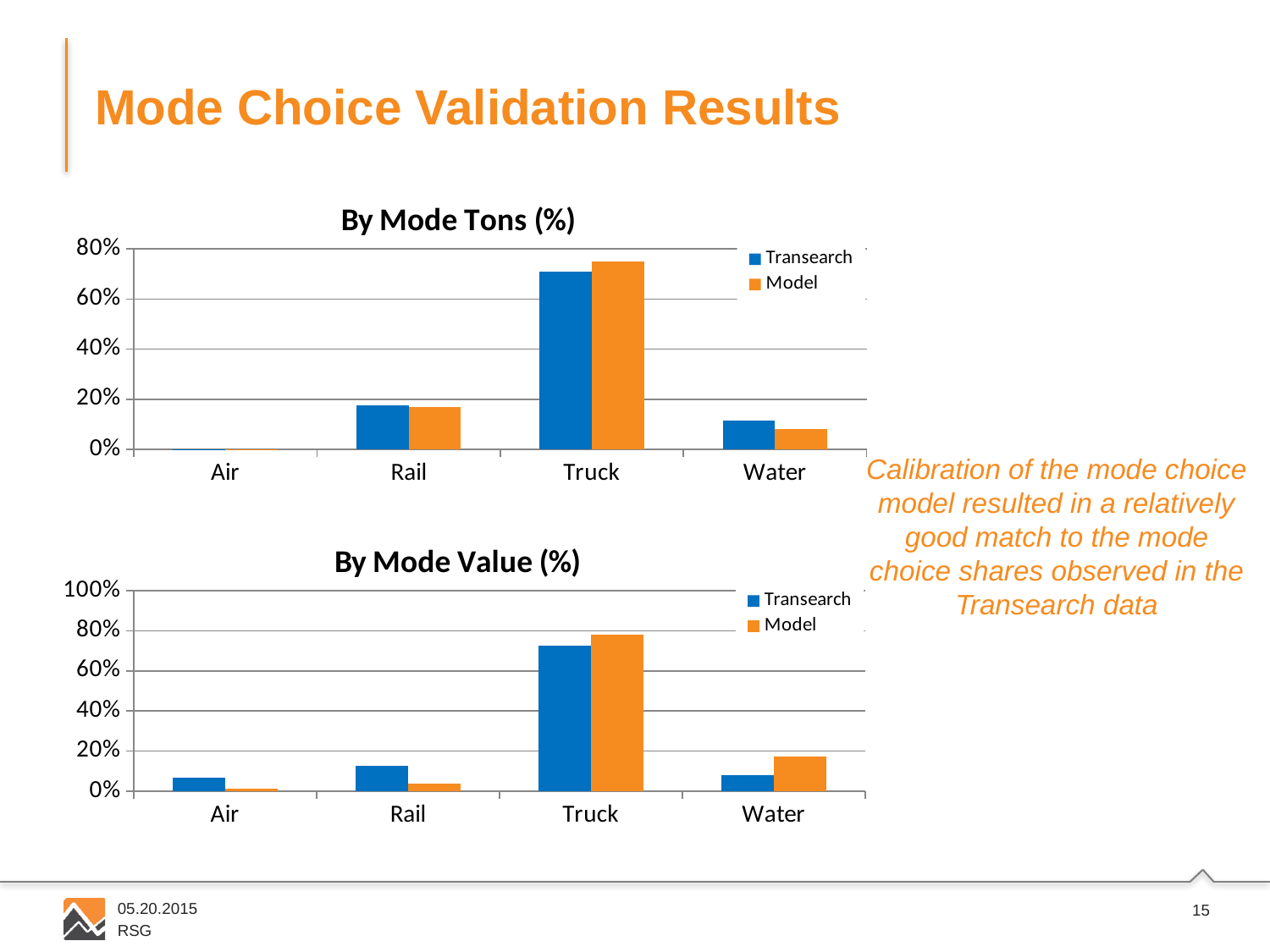
In the "By Mode Tons (%)" chart, how many series does the legend list? 2 In the "By Mode Tons (%)" chart, is the Model value for Rail greater or less than 20%? less In the "By Mode Tons (%)" chart, which mode has the highest Transearch share? Truck In the "By Mode Tons (%)" chart, is the Transearch value for Truck greater or less than 60%? greater What are the two legend entries in the "By Mode Value (%)" chart? Transearch and Model In the "By Mode Value (%)" chart, which mode has the highest Model share? Truck In the "By Mode Value (%)" chart, for Rail, which series has the larger value, Transearch or Model? Transearch In the "By Mode Value (%)" chart, is the Model value for Truck greater or less than 60%? greater In the "By Mode Value (%)" chart, for Water, which series has the larger value, Transearch or Model? Model In the "By Mode Tons (%)" chart, how many mode categories are shown on the x axis? 4 In the "By Mode Tons (%)" chart, which mode has the lowest Model share? Air What kind of chart is the "By Mode Tons (%)" chart? bar chart